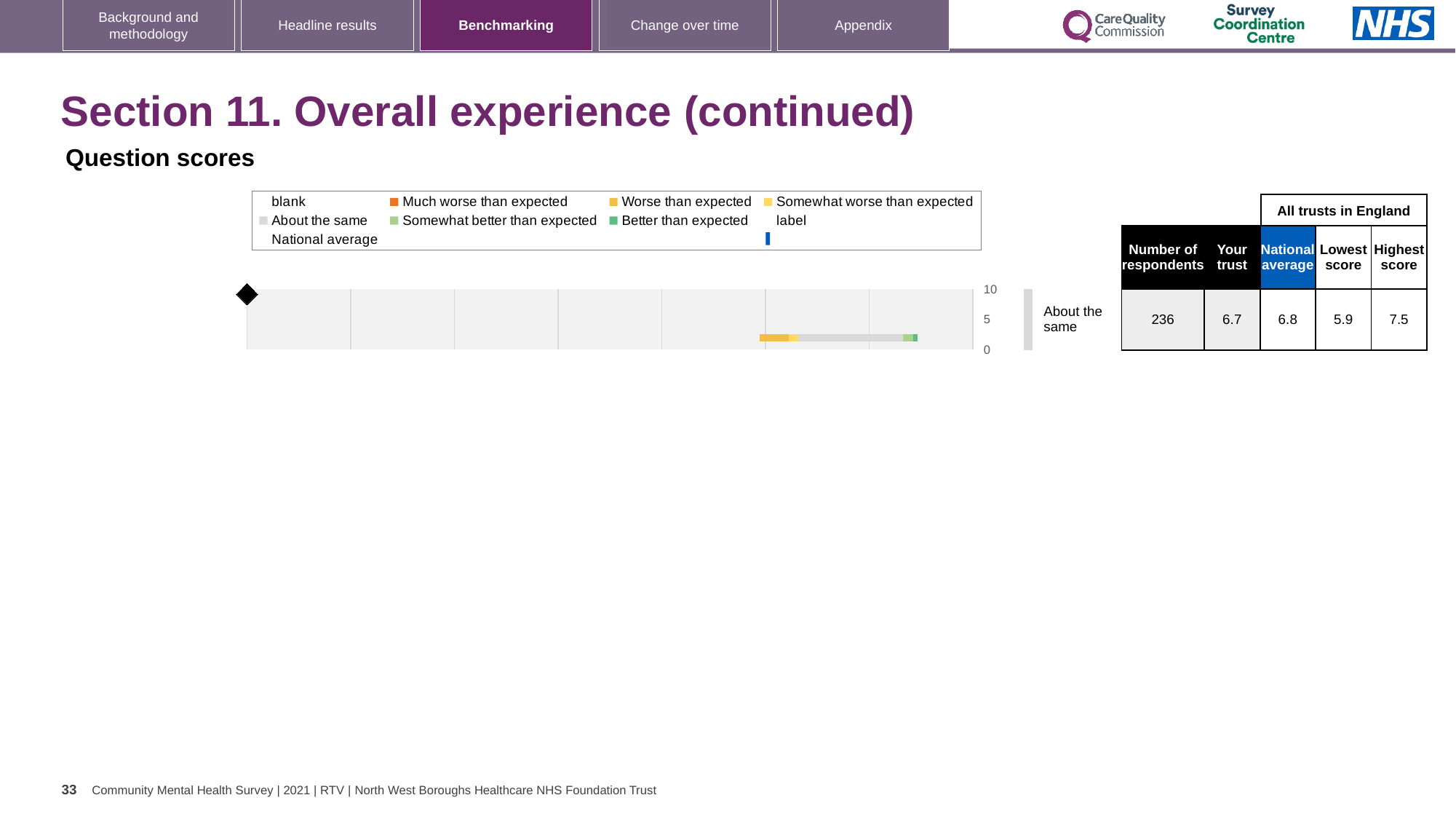
What is the Highest score among all trusts in England for this question? 7.5 What is the maximum value shown on the chart's axis? 10 Is the Your trust score greater or less than 5? greater What benchmark category label is shown next to the bar? About the same What is the score for Your trust on the 'About the same' question? 6.7 Which is larger, the Your trust score or the National average score? National average What is the Lowest score among all trusts in England for this question? 5.9 What is the National average score shown for this question? 6.8 How many respondents are recorded for this question? 236 What kind of chart is shown on the slide? bar chart What is the difference between the Highest score and the Lowest score? 1.6 What is the difference between the National average and the Your trust score? 0.1